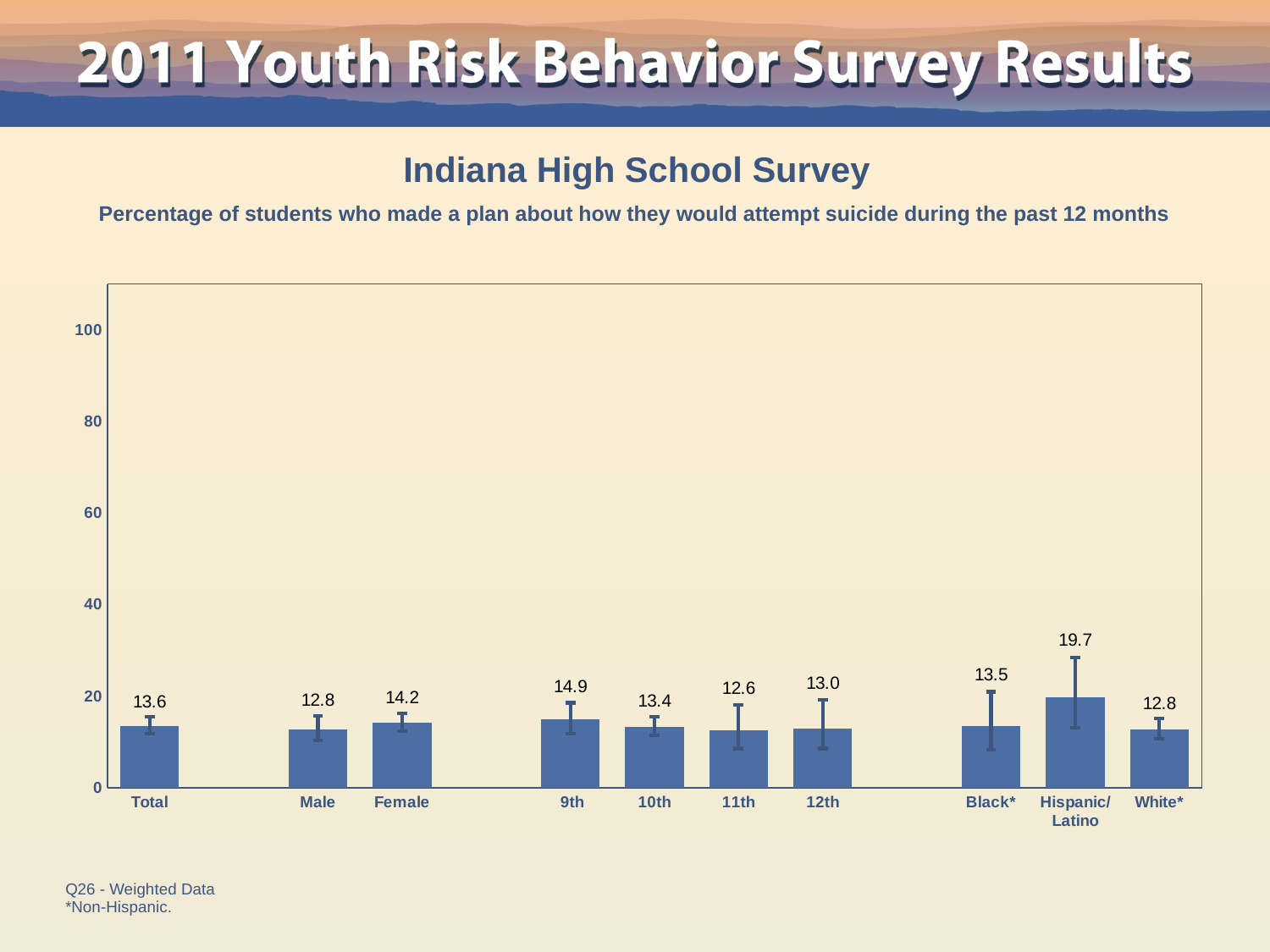
How many categories are shown on the x axis? 10 What is the difference between the Female and Male values? 1.4 Which category has the highest value? Hispanic/Latino What kind of chart is shown on the slide? bar chart Which is larger, the value for 9th grade or the value for 12th grade? 9th What is the title of the chart? Indiana High School Survey What is the value for Total? 13.6 What is the difference between the Hispanic/Latino and White* values? 6.9 Is the value for Hispanic/Latino greater or less than 20? less What is the value for 9th grade students? 14.9 Which grade level has the lowest value? 11th What is the value for Hispanic/Latino students? 19.7